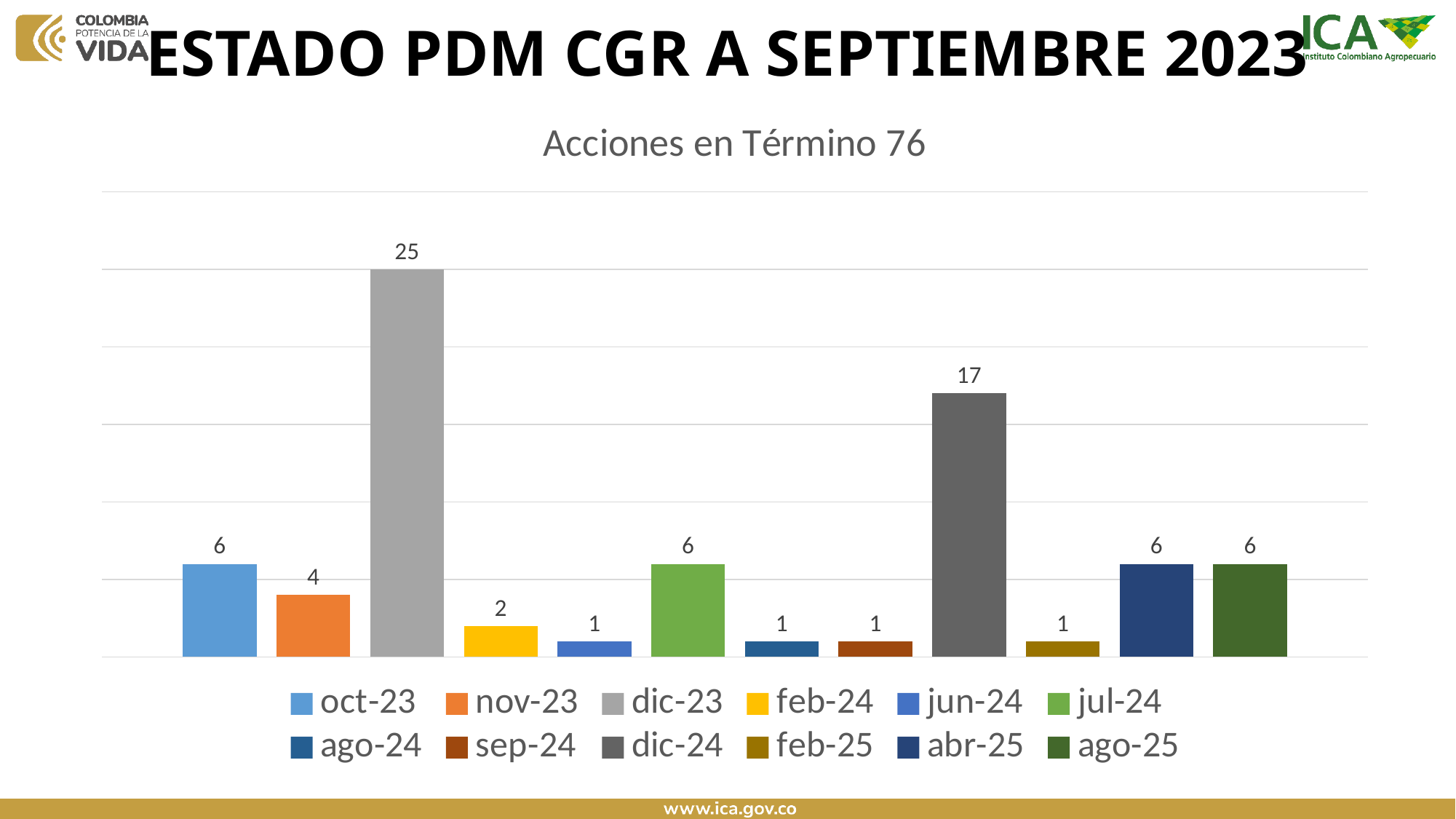
What is the value for dic-24? 17 What is the value for nov-23? 4 How many entries does the legend list? 12 What is the difference between the values for jul-24 and jun-24? 5 What is the title of the chart? Acciones en Término 76 Which is larger, the value for oct-23 or the value for nov-23? oct-23 What is the value for feb-24? 2 What is the difference between the values for dic-23 and dic-24? 8 What is the value for dic-23? 25 What type of chart is shown on the slide? bar chart Which month has the highest value? dic-23 How many bars are plotted in the chart? 12